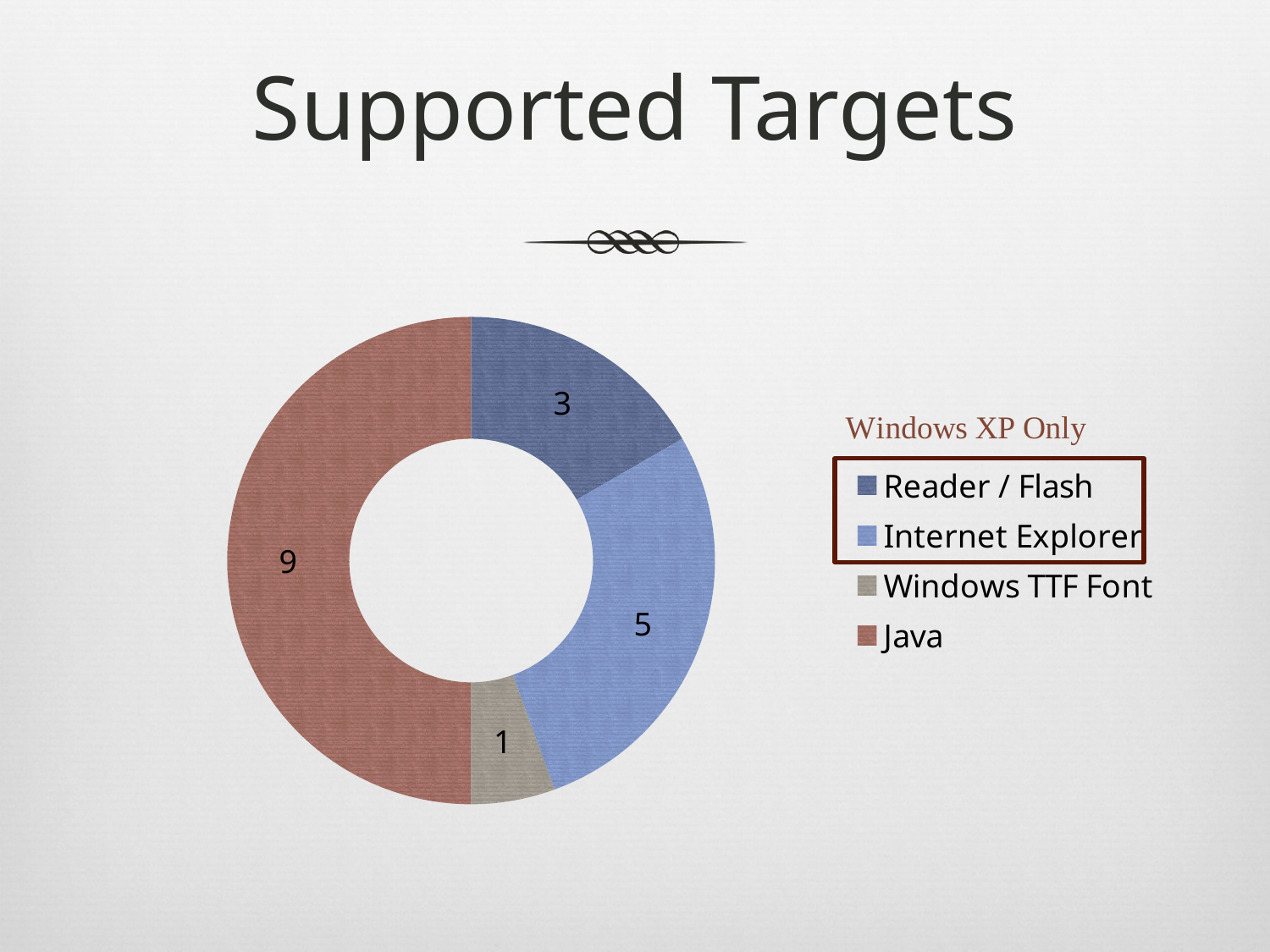
Which two legend entries are enclosed in the box labelled 'Windows XP Only'? Reader / Flash and Internet Explorer What is the difference between the values for Java and Internet Explorer? 4 Which category has the smallest value? Windows TTF Font What kind of chart is shown on the slide? doughnut chart Which is larger, the value for Internet Explorer or the value for Reader / Flash? Internet Explorer What share of the total does Java represent? 50% What is the value for Windows TTF Font? 1 How many categories does the chart show? 4 What is the value for Internet Explorer? 5 What is the value for Reader / Flash? 3 What is the value for Java? 9 Which category has the largest value? Java